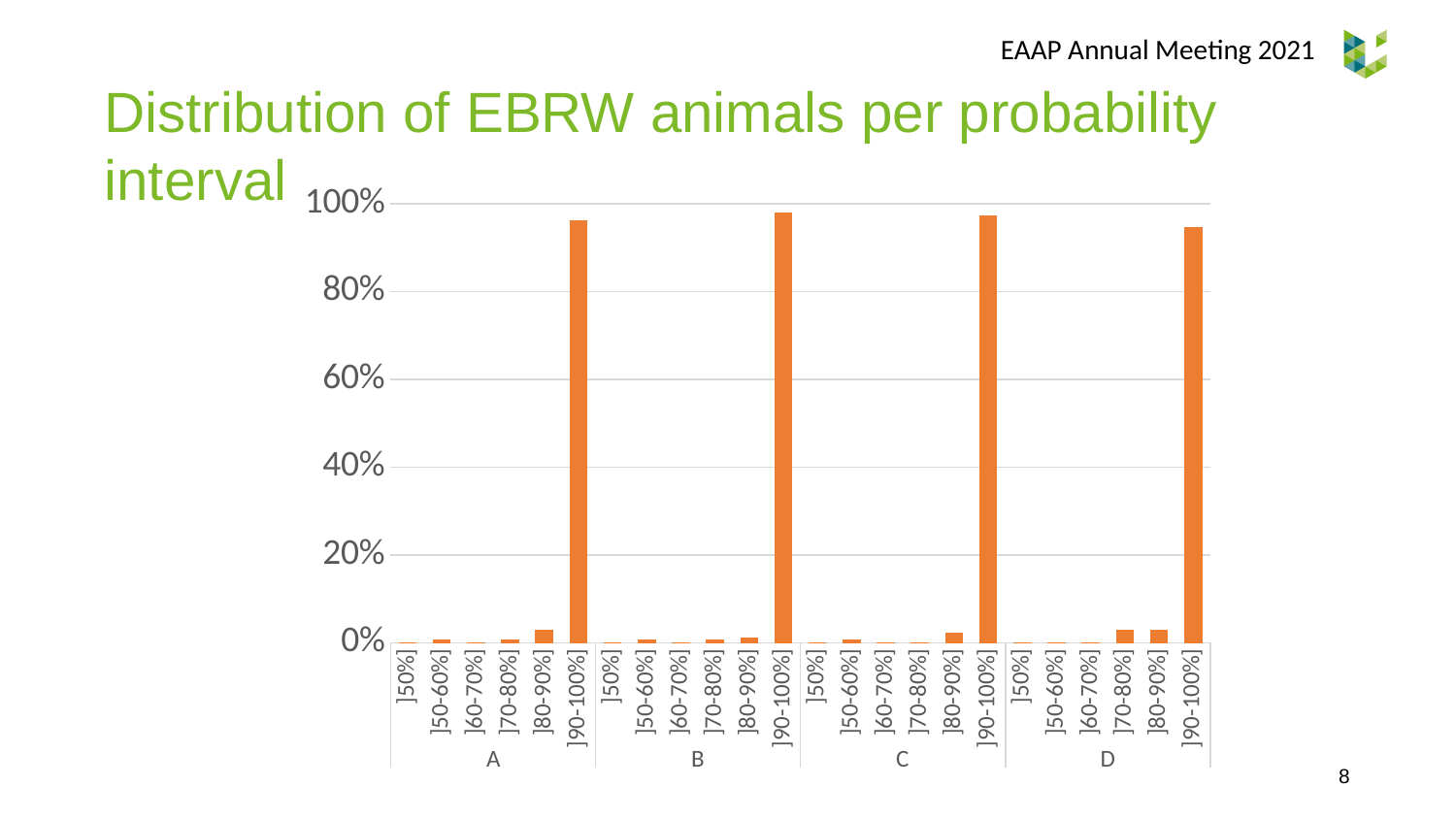
What kind of chart is shown on the slide? bar chart Which probability interval has the highest value in group A? ]90-100%] Which probability interval has the highest value in group D? ]90-100%] Which is larger: the value for ]70-80%] in group D or the value for ]90-100%] in group D? ]90-100%] in group D Which is larger: the value for ]90-100%] in group A or the value for ]80-90%] in group A? ]90-100%] in group A How many probability intervals are shown within each group on the x axis? 6 Is the value for ]80-90%] in group C greater or less than 20%? less How many groups (A, B, C, D) are shown along the x axis? 4 Is the value for ]90-100%] in group B greater or less than 80%? greater What is the highest value shown on the y axis? 100% What is the title of the chart on the slide? Distribution of EBRW animals per probability interval Is the value for ]90-100%] in group D greater or less than 60%? greater